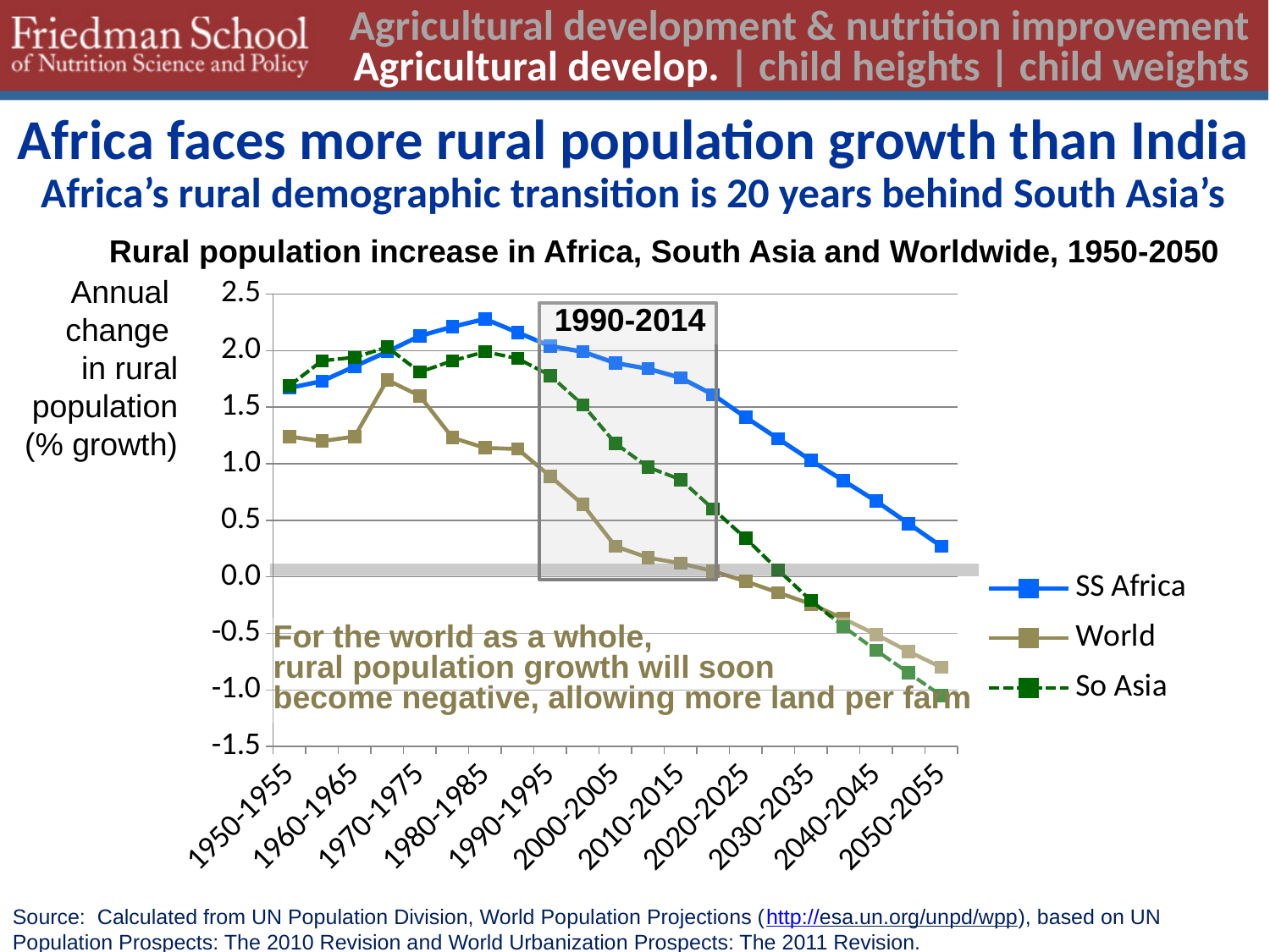
What kind of chart is shown on the slide? Line chart Does the SS Africa series rise or fall from 1990-1995 to 2050-2055? Fall What is the title of the chart? Rural population increase in Africa, South Asia and Worldwide, 1950-2050 How many series does the legend list? 3 Is the value for SS Africa in 1950-1955 greater or less than 1.5? greater Is the value for World in 2050-2055 greater or less than -0.5? less Which series has the lowest value in 2050-2055? So Asia Is the value for World in 1950-1955 greater or less than 1.0? greater Which series are listed in the chart legend? SS Africa, World, So Asia Which series has the highest value in 2050-2055? SS Africa In 1950-1955, which is larger: the value for SS Africa or the value for World? SS Africa